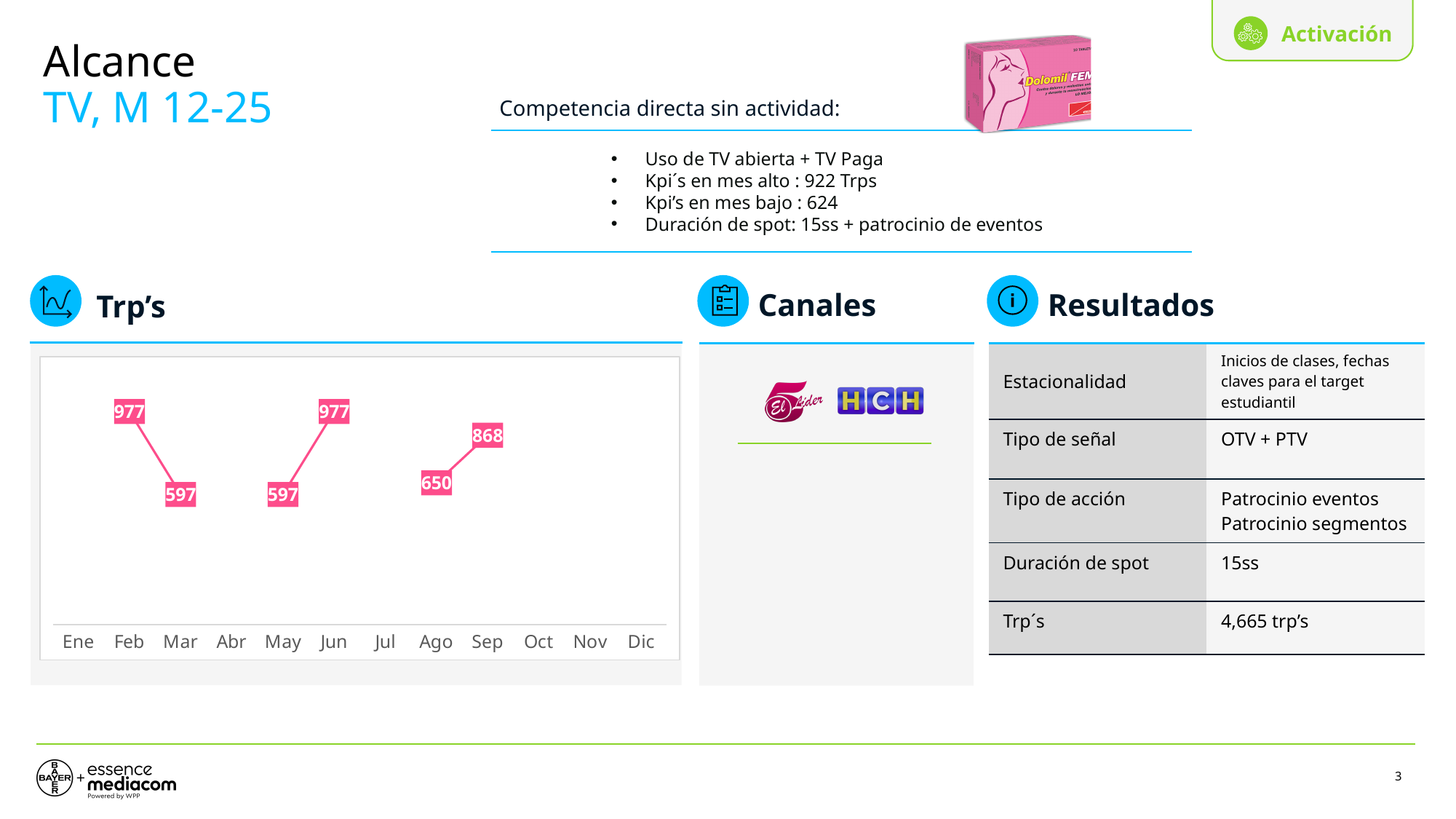
What is the difference between the Trp's values for Jun and May? 380 What is the Trp's value for Ago? 650 What is the difference between the Trp's values for Sep and Ago? 218 What is the Trp's value for Sep? 868 How many data points carry labels in the Trp's chart? 6 What is the Trp's value for Feb? 977 Which month has the lowest labelled Trp's value? Mar and May (597) How many months are listed on the x axis of the Trp's chart? 12 Which is larger, the Trp's value for Sep or for Ago? Sep What is the Trp's value for Mar? 597 Do the Trp's values rise or fall from Ago to Sep? rise What type of chart is shown under the Trp's heading? line chart